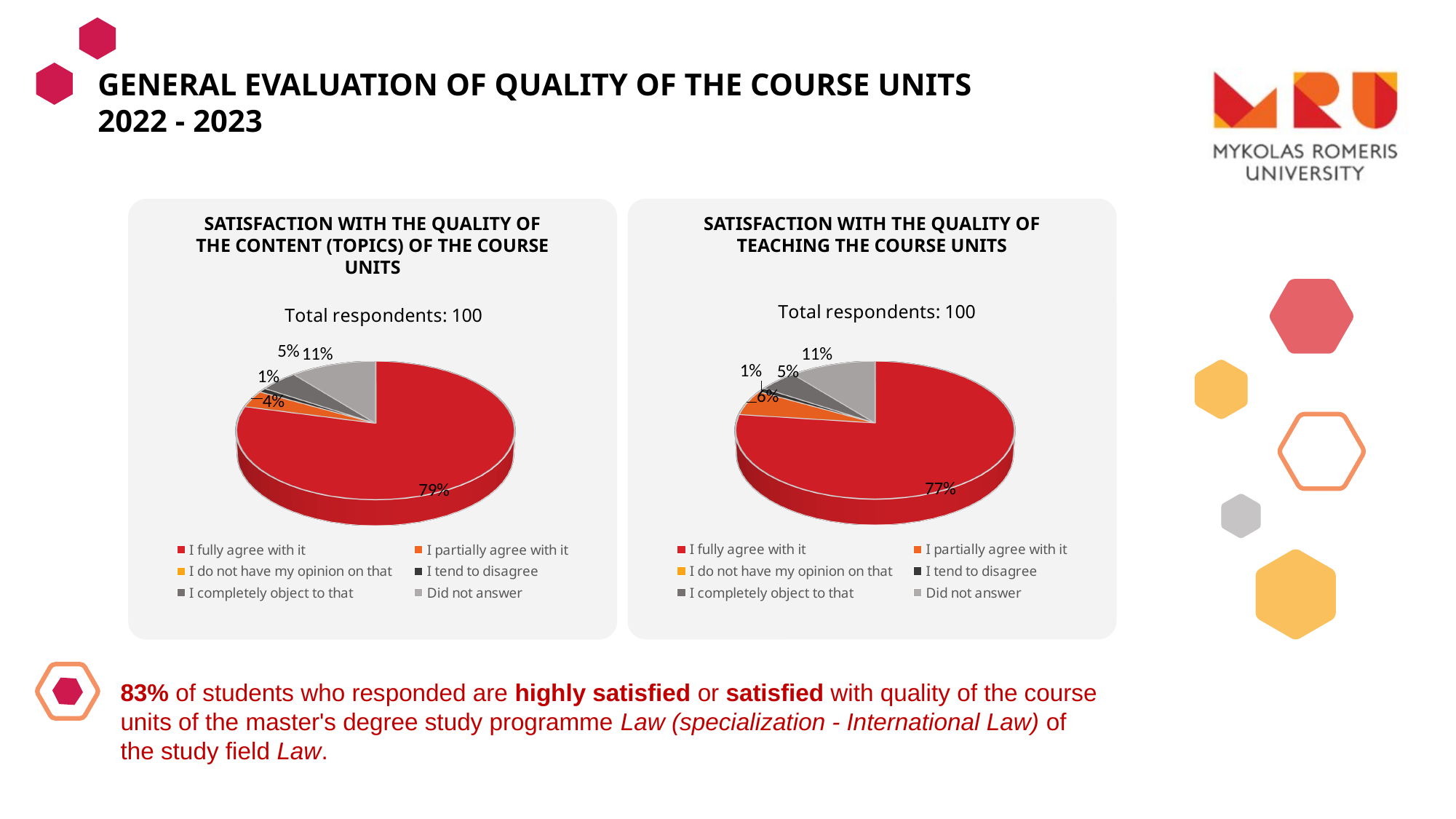
In the chart 'Satisfaction with the quality of teaching the course units', what percentage of respondents 'Did not answer'? 11% In the chart 'Satisfaction with the quality of the content (topics) of the course units', what percentage chose 'I partially agree with it'? 4% What type of chart is used in the 'Satisfaction with the quality of teaching the course units' panel? Pie chart In the chart 'Satisfaction with the quality of teaching the course units', what percentage chose 'I partially agree with it'? 6% In the chart 'Satisfaction with the quality of teaching the course units', what percentage of respondents chose 'I fully agree with it'? 77% How many total respondents are reported for the 'Satisfaction with the quality of teaching the course units' chart? 100 In the chart 'Satisfaction with the quality of the content (topics) of the course units', which response has the largest share? I fully agree with it In the chart 'Satisfaction with the quality of the content (topics) of the course units', what percentage of respondents chose 'I fully agree with it'? 79% What is the difference between the 'I fully agree with it' share in the content (topics) chart and in the teaching chart? 2 percentage points In the chart 'Satisfaction with the quality of the content (topics) of the course units', what colour is the 'I fully agree with it' slice? Red How many response categories does the legend of the 'Satisfaction with the quality of the content (topics) of the course units' chart list? 6 Which chart has the larger share for 'I fully agree with it': the content (topics) chart or the teaching chart? The content (topics) chart